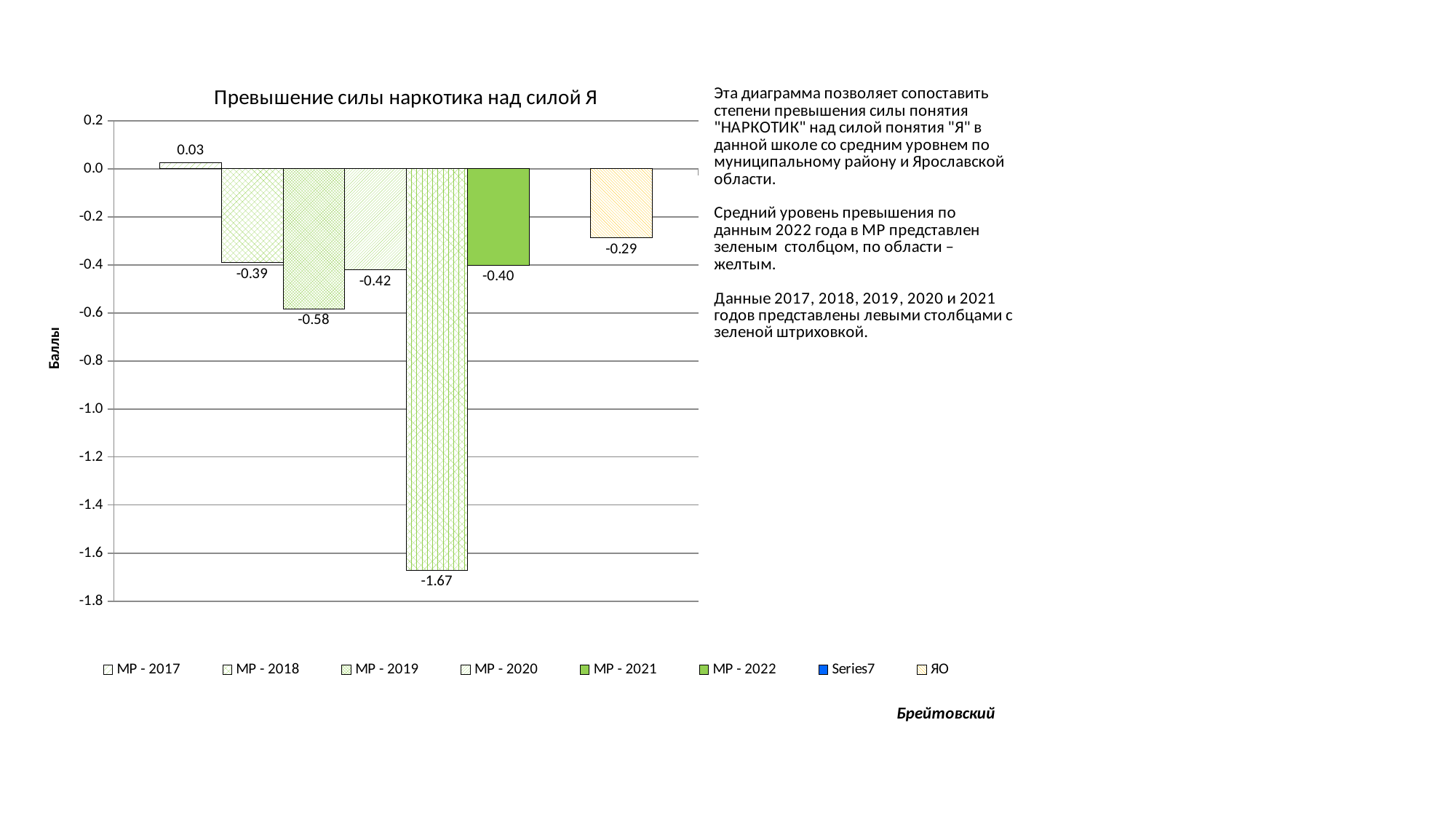
What is the value for МР - 2021? -1.67 What type of chart is shown on the slide? bar chart What is the value for МР - 2017? 0.03 Which is larger, the value for МР - 2018 or the value for МР - 2020? МР - 2018 What is the value for МР - 2019? -0.58 Which series has the highest value? МР - 2017 What is the value of the yellow bar (ЯО)? -0.29 What is the difference between the values for МР - 2022 and ЯО? 0.11 Which series has the lowest value? МР - 2021 What is the value of the solid green bar (МР - 2022)? -0.40 How many entries does the legend list? 8 What is the title of the chart? Превышение силы наркотика над силой Я